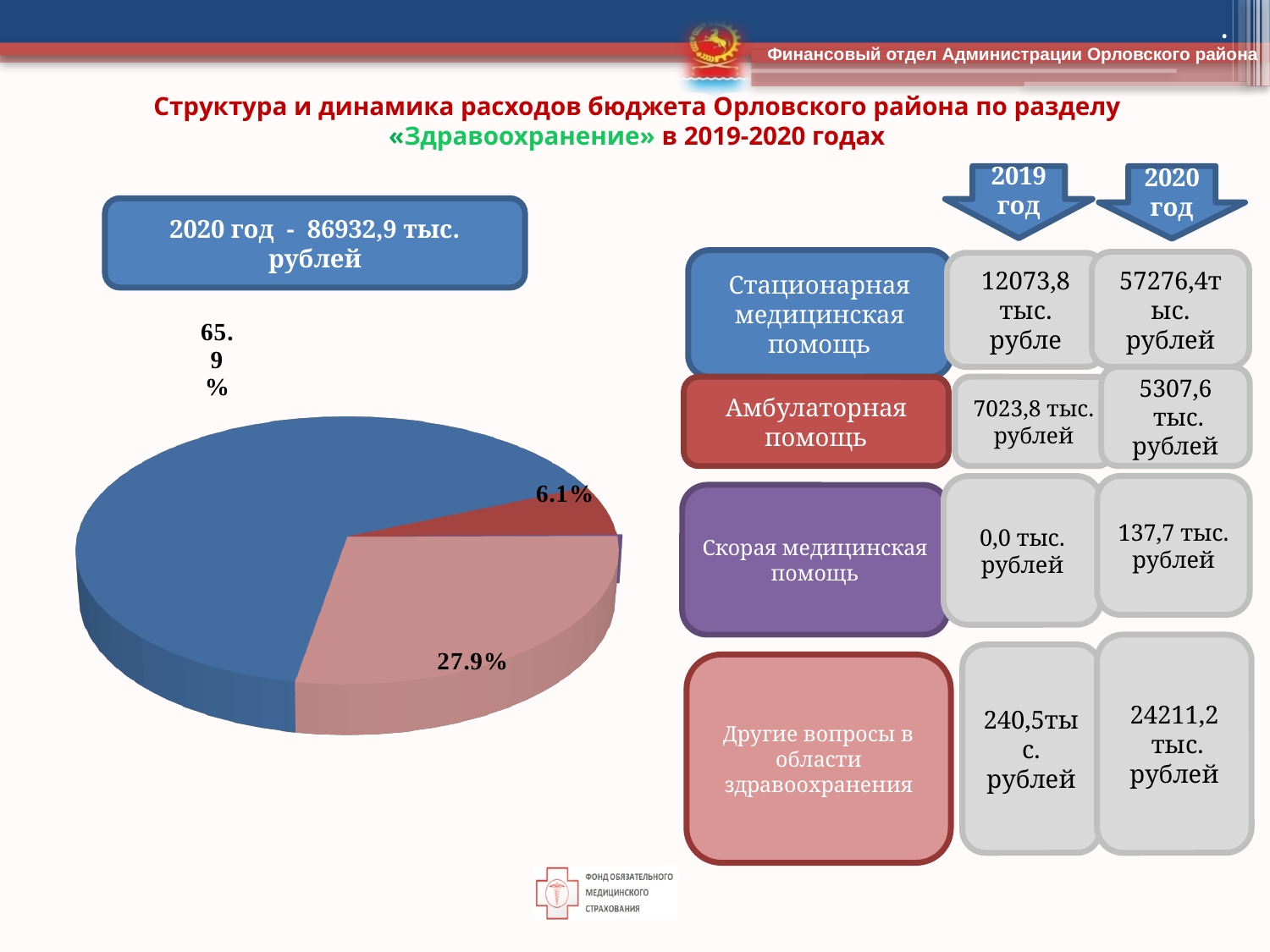
Does the pie chart have a legend? No Which slice is larger on the pie chart, the pink one or the dark red one? the pink one (27.9%) What is the smallest percentage shown on the pie chart? 6.1% What percentage is labelled on the pink slice of the pie chart? 27.9% What percentage is labelled on the blue slice of the pie chart? 65.9% By how many percentage points does the largest slice (65.9%) exceed the 27.9% slice? 38.0 percentage points What percentage is labelled on the dark red slice of the pie chart? 6.1% What colour is the largest slice of the pie chart? blue Is the share of the blue slice greater or less than 50%? greater How many slices are labelled on the pie chart? 3 What is the largest percentage shown on the pie chart? 65.9% What kind of chart is shown on the left of the slide? pie chart